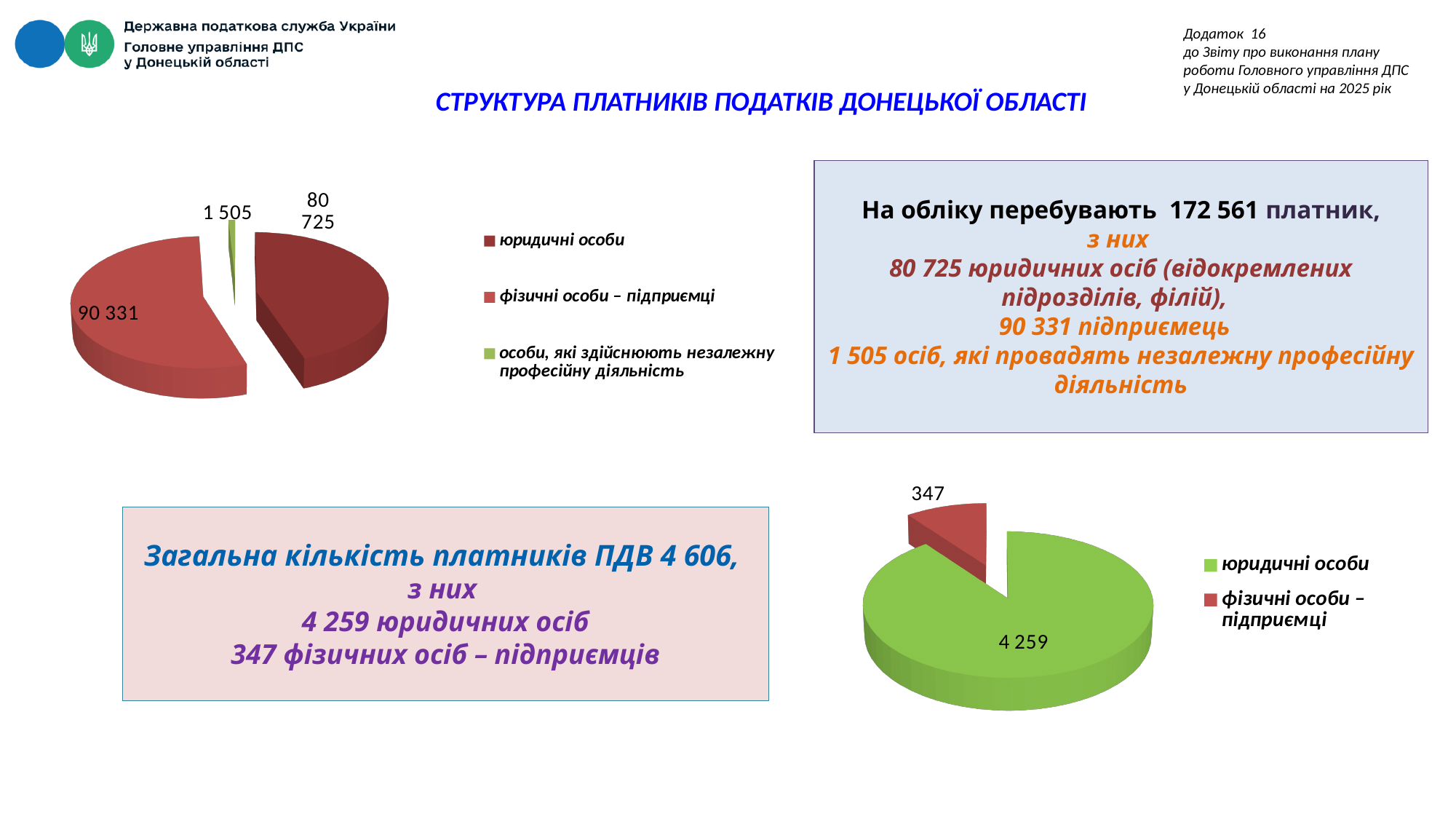
On the top-left pie chart, what is the difference between фізичні особи – підприємці and юридичні особи? 9 606 On the top-left pie chart, how many categories does the legend list? 3 On the top-left pie chart, what is the value for фізичні особи – підприємці? 90 331 On the top-left pie chart, which category has the largest slice? фізичні особи – підприємці On the bottom-right pie chart, what is the total of the two slices? 4 606 What type of chart is the bottom-right chart? pie chart On the top-left pie chart, what is the value for особи, які здійснюють незалежну професійну діяльність? 1 505 On the bottom-right pie chart, what is the value for юридичні особи? 4 259 On the top-left pie chart, which category has the smallest slice? особи, які здійснюють незалежну професійну діяльність On the bottom-right pie chart, what is the value for фізичні особи – підприємці? 347 On the top-left pie chart, what is the value for юридичні особи? 80 725 On the bottom-right pie chart, which is larger: юридичні особи or фізичні особи – підприємці? юридичні особи